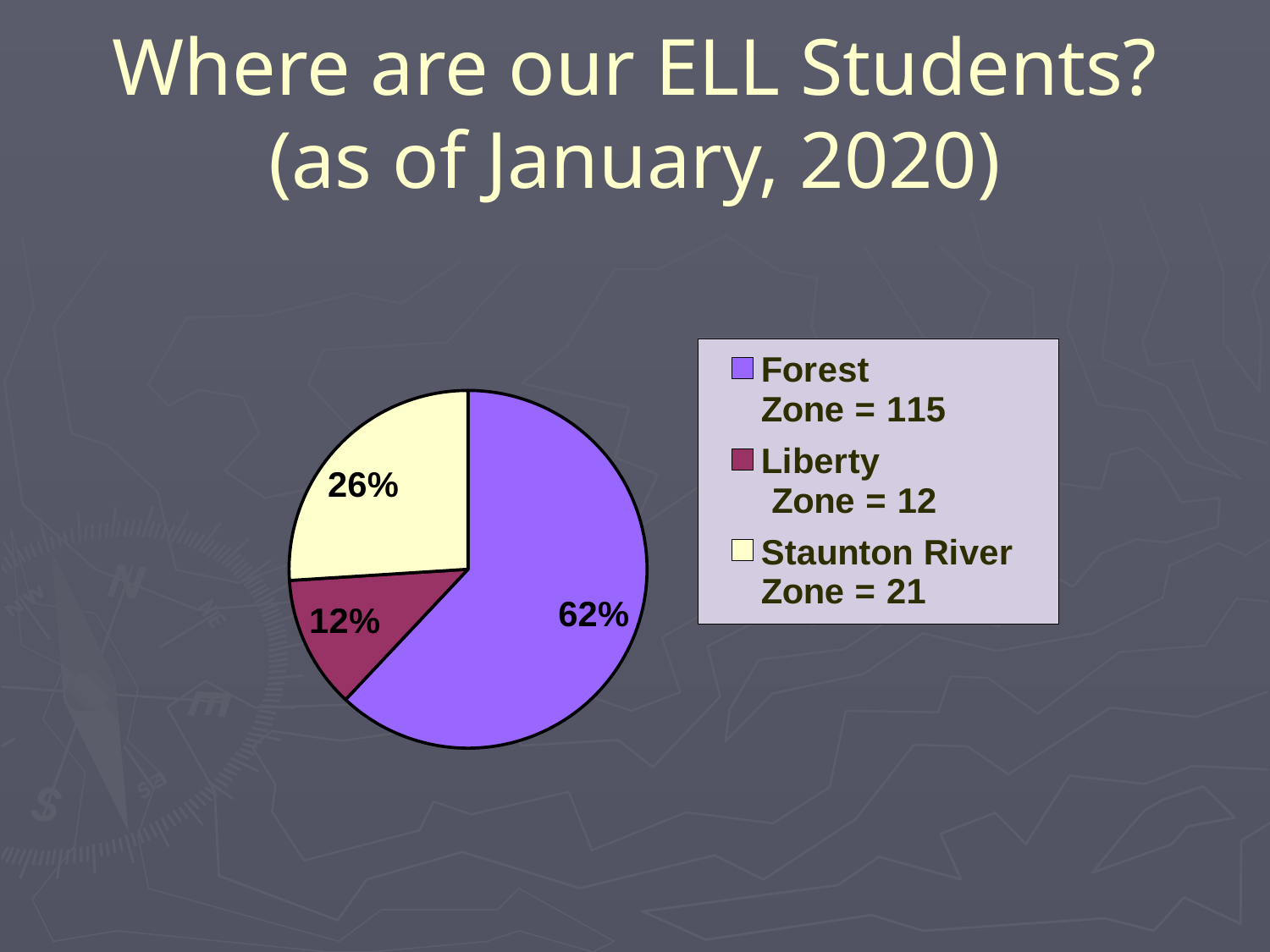
Which zone has the largest share of ELL students? Forest Zone According to the legend, how many ELL students are in the Staunton River Zone? 21 How many more ELL students are in the Forest Zone than in the Staunton River Zone, based on the legend counts? 94 Which has more ELL students, the Staunton River Zone or the Liberty Zone? Staunton River Zone What percentage of the pie does the Liberty Zone slice represent? 12% What kind of chart is shown on the slide? pie chart What percentage of the pie does the Staunton River Zone slice represent? 26% What percentage of the pie does the Forest Zone slice represent? 62% According to the legend, how many ELL students are in the Forest Zone? 115 Which zone has the smallest share of ELL students? Liberty Zone According to the legend, how many ELL students are in the Liberty Zone? 12 How many slices does the pie chart have? 3